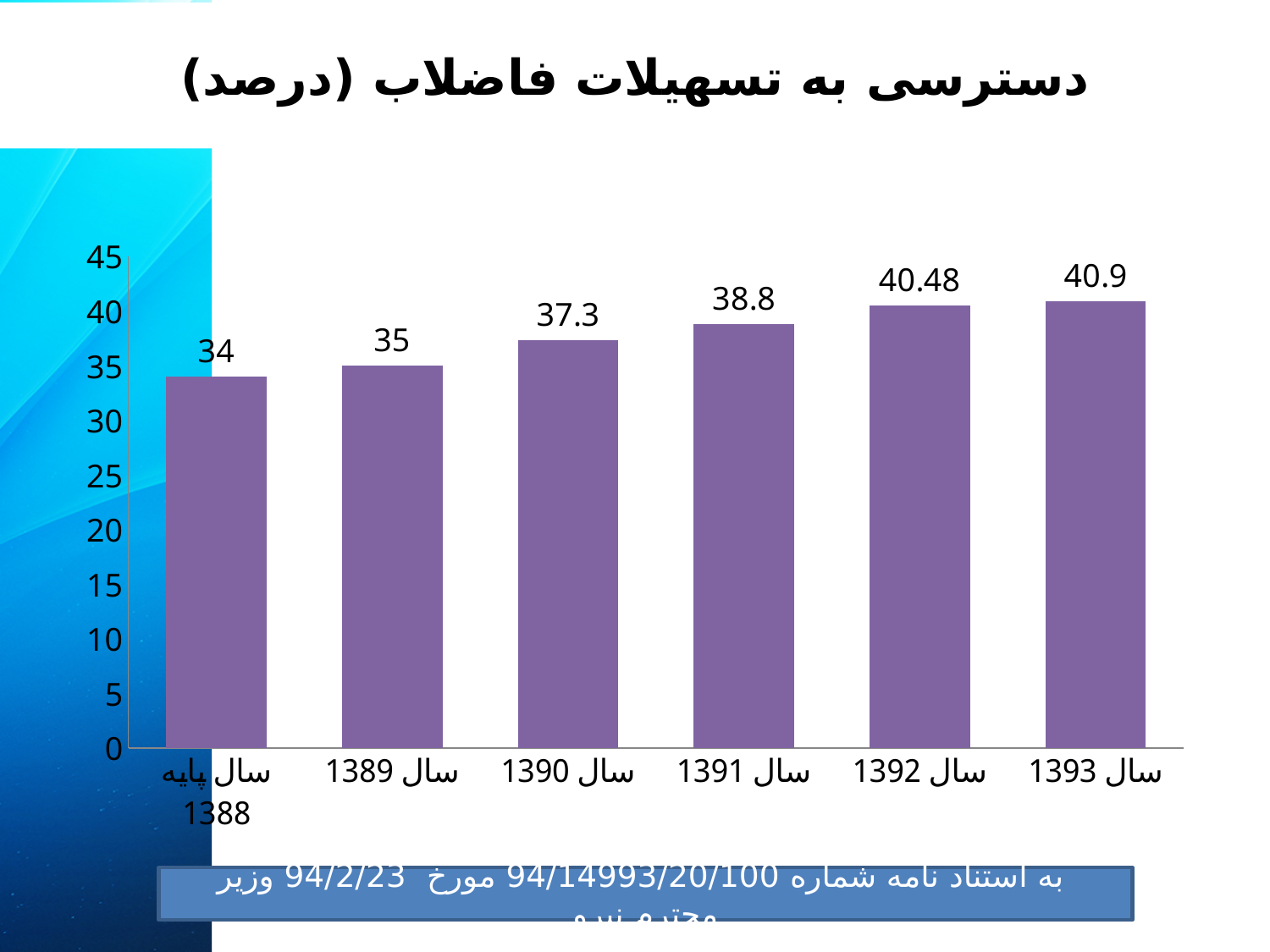
What kind of chart is shown on the slide? bar chart Which is larger, the value for سال 1390 or the value for سال 1389? سال 1390 What is the value for the base year, سال پایه 1388? 34 What is the value for سال 1390 (year 1390)? 37.3 Which year has the highest value? سال 1393 What is the difference between the values for سال 1393 and سال پایه 1388? 6.9 How many years (categories) are shown on the chart? 6 What is the difference between the values for سال 1391 and سال 1389? 3.8 Which year has the lowest value? سال پایه 1388 What is the value for سال 1392 (year 1392)? 40.48 Is the value for سال 1391 greater or less than 40? less Do the values rise or fall from سال پایه 1388 to سال 1393? rise